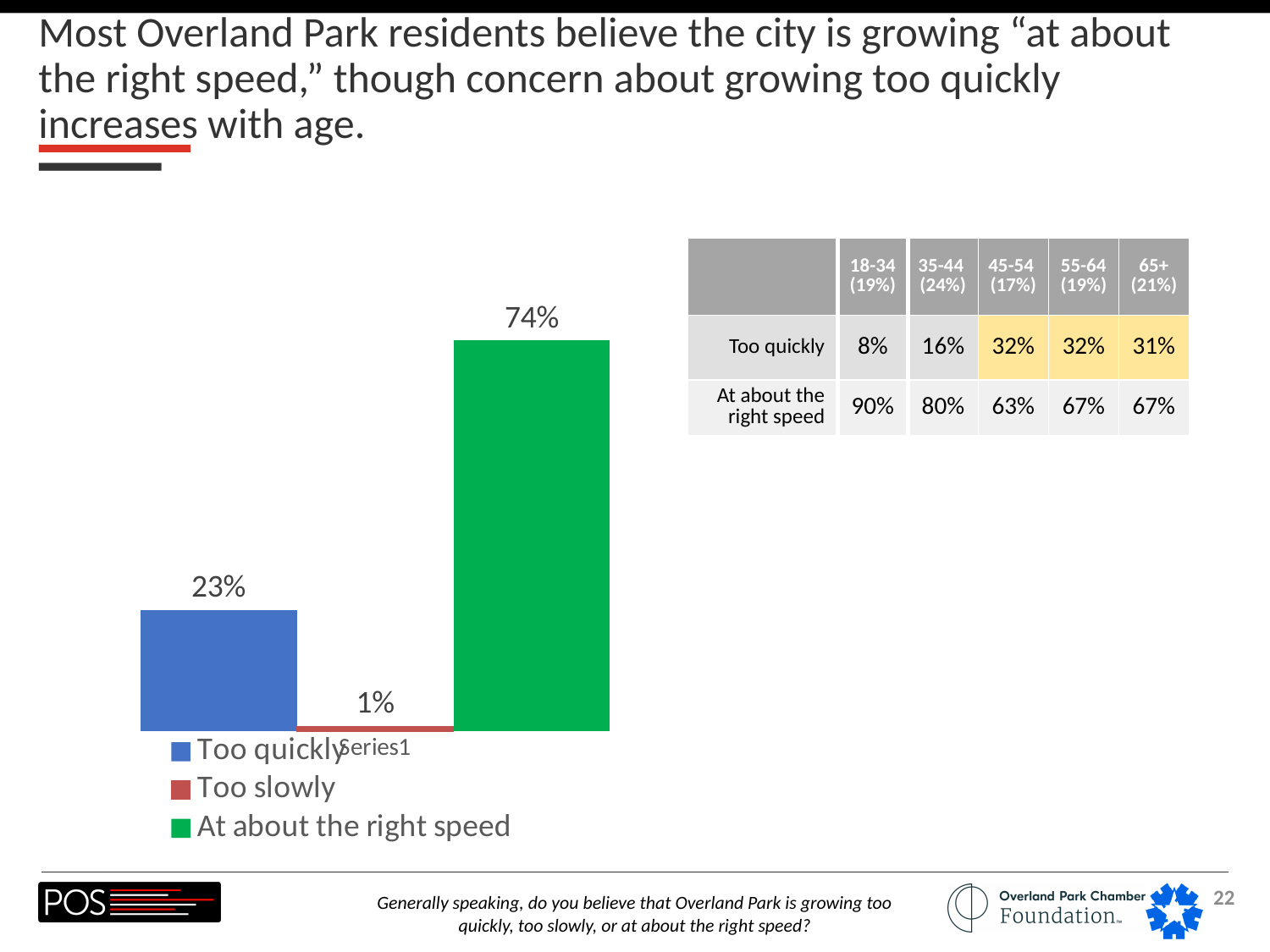
What colour is the bar for 'Too quickly'? Blue What colour is the bar for 'At about the right speed'? Green What is the difference between the 'Too quickly' value and the 'Too slowly' value? 22% What is the difference between the 'At about the right speed' value and the 'Too quickly' value? 51% How many series does the chart legend list? 3 What percentage of respondents said Overland Park is growing at about the right speed? 74% Which response has the lowest value in the chart? Too slowly What percentage of respondents said Overland Park is growing too quickly? 23% Which is larger, the value for 'Too quickly' or the value for 'Too slowly'? Too quickly What percentage of respondents said Overland Park is growing too slowly? 1% What kind of chart is shown on the slide? Bar chart Which response has the highest value in the chart? At about the right speed